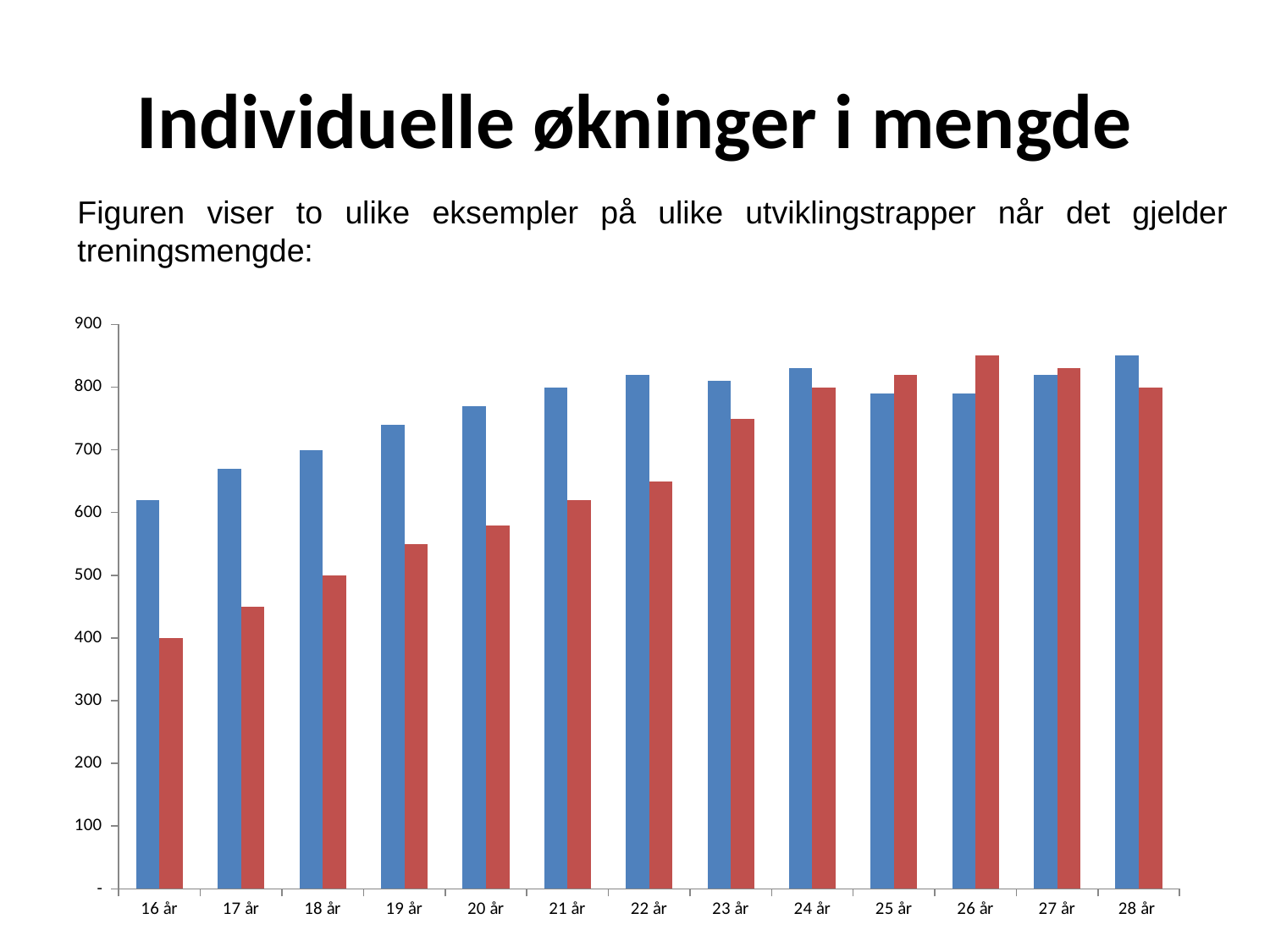
How many bar series (colours) are plotted in the chart? 2 Is the value of the red bar for 20 år greater or less than 600? less Is the value of the blue bar for 24 år greater or less than 800? greater Is the value of the red bar for 16 år greater or less than 500? less How many age categories are shown on the x axis of the chart? 13 Which is larger at 26 år, the blue bar or the red bar? the red bar Do the red bars generally rise or fall from 16 år to 26 år? rise Which is larger at 19 år, the blue bar or the red bar? the blue bar Which age category has the lowest red bar? 16 år What kind of chart is shown on the slide? bar chart